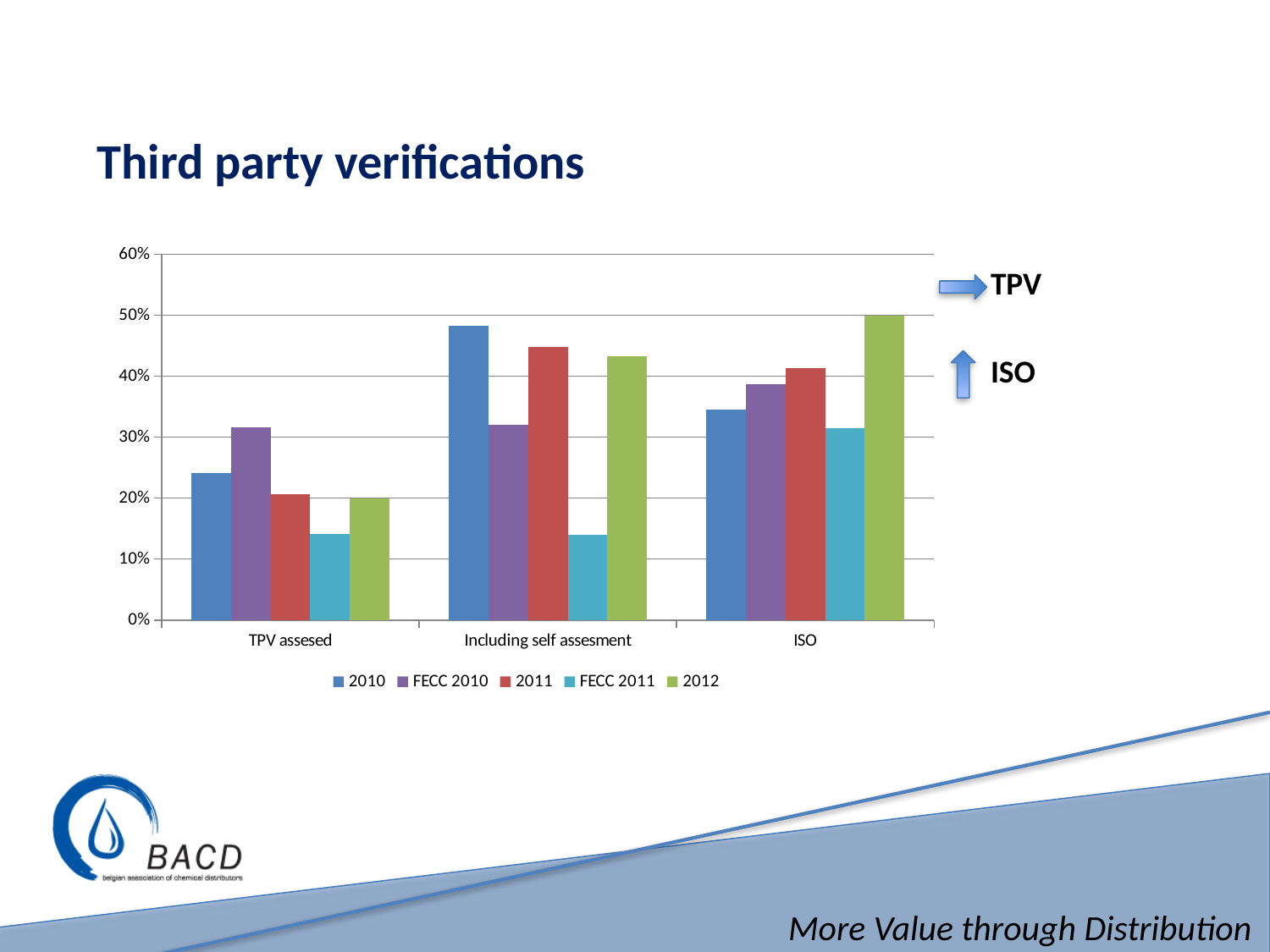
Is the value for FECC 2011 in the TPV assesed category greater or less than 20%? less How many series does the legend list? 5 Is the value for 2010 in the Including self assesment category greater or less than 40%? greater Is the value for 2012 in the ISO category greater or less than 40%? greater Which series has the highest value in the ISO category? 2012 Which is larger in the ISO category: the 2011 value or the FECC 2011 value? 2011 Which is larger in the TPV assesed category: the 2010 value or the 2011 value? 2010 Which series has the lowest value in the Including self assesment category? FECC 2011 What kind of chart is shown on the slide? bar chart How many categories are shown on the x axis? 3 What is the title of the slide containing the chart? Third party verifications Which series has the highest value in the TPV assesed category? FECC 2010